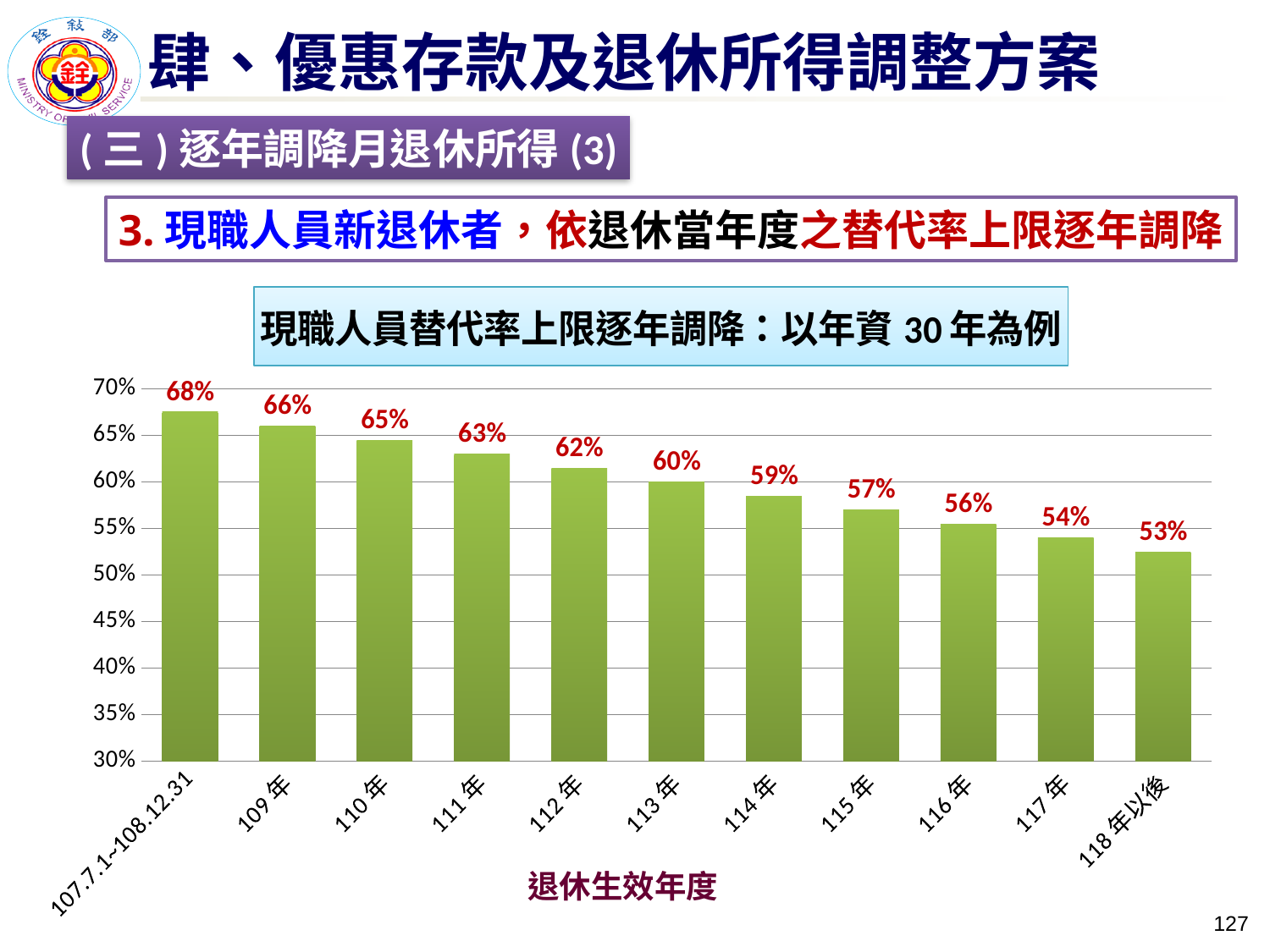
What is the difference between the values for 110年 and 115年? 8% Which is larger, the value for 112年 or the value for 116年? 112年 What is the value shown for 113年? 60% What kind of chart is shown on the slide? Bar chart What is the value shown for 118年以後? 53% Which retirement year category has the lowest value? 118年以後 What is the value shown for 107.7.1~108.12.31? 68% Which retirement year category has the highest value? 107.7.1~108.12.31 What is the replacement rate cap shown for 109年? 66% Do the values rise or fall as the retirement year moves from left to right? Fall How many categories are shown on the x axis? 11 What is the x-axis title of the chart? 退休生效年度